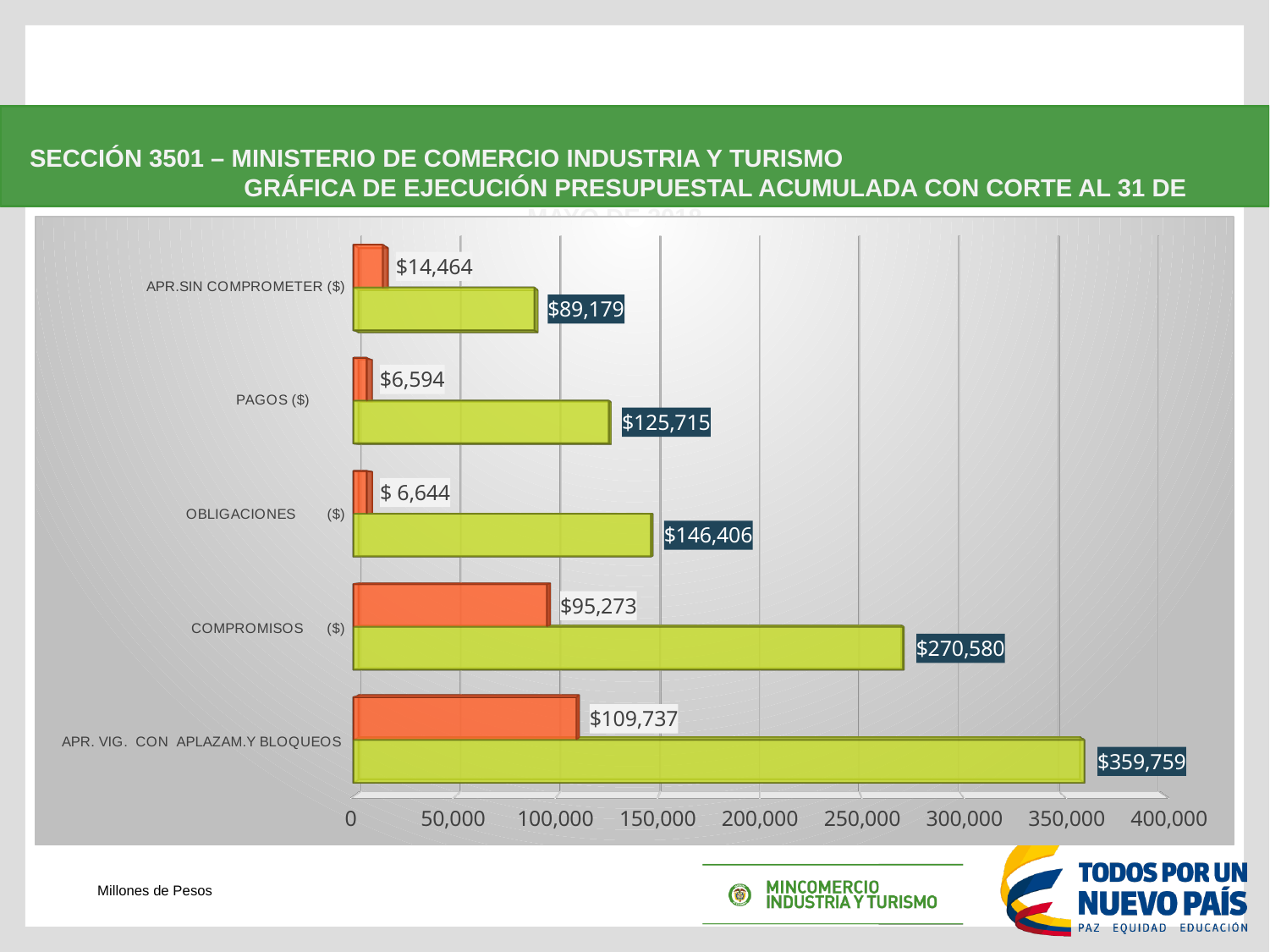
How many categories are shown on the chart? 5 What is the difference between the green bar values for COMPROMISOS ($) and OBLIGACIONES ($)? $124,174 What is the value of the green bar for APR. VIG. CON APLAZAM.Y BLOQUEOS? $359,759 Is the green bar value for PAGOS ($) greater or less than 150,000? less What is the difference between the orange bar values for APR. VIG. CON APLAZAM.Y BLOQUEOS and COMPROMISOS ($)? $14,464 What is the value of the orange bar for PAGOS ($)? $6,594 What is the value of the green bar for OBLIGACIONES ($)? $146,406 Which category has the lowest green bar value? APR.SIN COMPROMETER ($) What kind of chart is shown on the slide? bar chart Which category has the highest green bar value? APR. VIG. CON APLAZAM.Y BLOQUEOS Which is larger: the orange bar for APR.SIN COMPROMETER ($) or the orange bar for COMPROMISOS ($)? COMPROMISOS ($) What is the value of the orange bar for COMPROMISOS ($)? $95,273